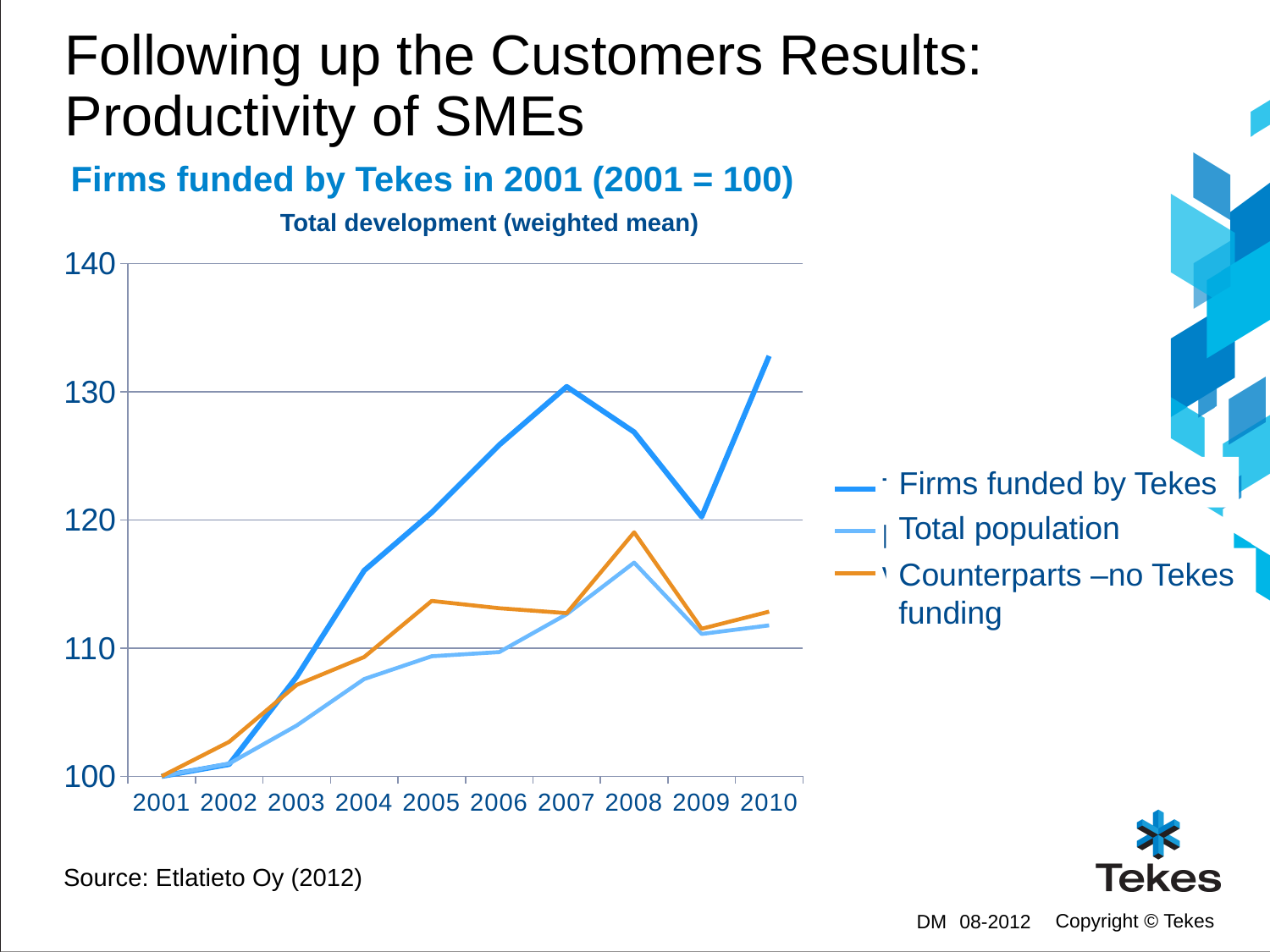
What is the title printed directly above the chart? Total development (weighted mean) What kind of chart is shown on the slide? line chart Does the Firms funded by Tekes series rise or fall from 2008 to 2009? fall How many years are shown on the x axis? 10 Is the value for Firms funded by Tekes in 2004 greater or less than 120? less What is the value for Firms funded by Tekes in 2001? 100 Is the value for Total population in 2008 greater or less than 110? greater Which series has the highest value in 2010? Firms funded by Tekes In which year does the Firms funded by Tekes series reach its highest value? 2010 How many series does the legend list? 3 In 2008, which is higher: Counterparts –no Tekes funding or Total population? Counterparts –no Tekes funding Is the value for Firms funded by Tekes in 2010 greater or less than 130? greater